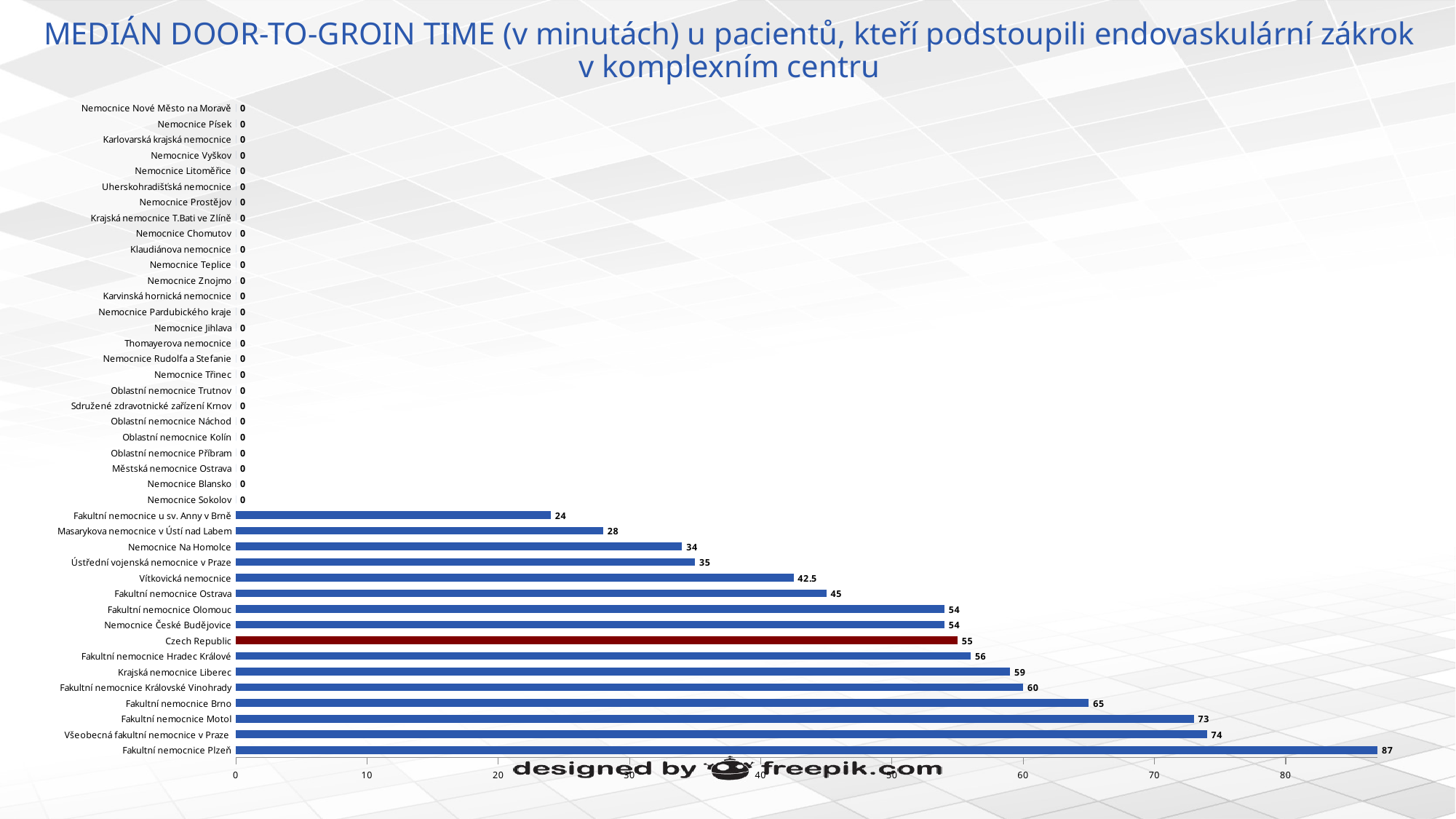
What is the value shown for Fakultní nemocnice Motol? 73 Which is larger, the value for Krajská nemocnice Liberec or the value for Fakultní nemocnice Hradec Králové? Krajská nemocnice Liberec What kind of chart is shown on the slide? bar chart Among hospitals with a non-zero value, which has the lowest median door-to-groin time? Fakultní nemocnice u sv. Anny v Brně Which hospital has the highest median door-to-groin time? Fakultní nemocnice Plzeň Which bar is shown in a different colour (dark red) from the others? Czech Republic What is the difference between the values for Fakultní nemocnice Brno and Czech Republic? 10 What is the value shown for Vítkovická nemocnice? 42.5 What is the difference between the values for Fakultní nemocnice Plzeň and Všeobecná fakultní nemocnice v Praze? 13 Is the value for Fakultní nemocnice Ostrava greater or less than 40? greater What is the value shown for Czech Republic? 55 What is the median door-to-groin time for Fakultní nemocnice Plzeň? 87